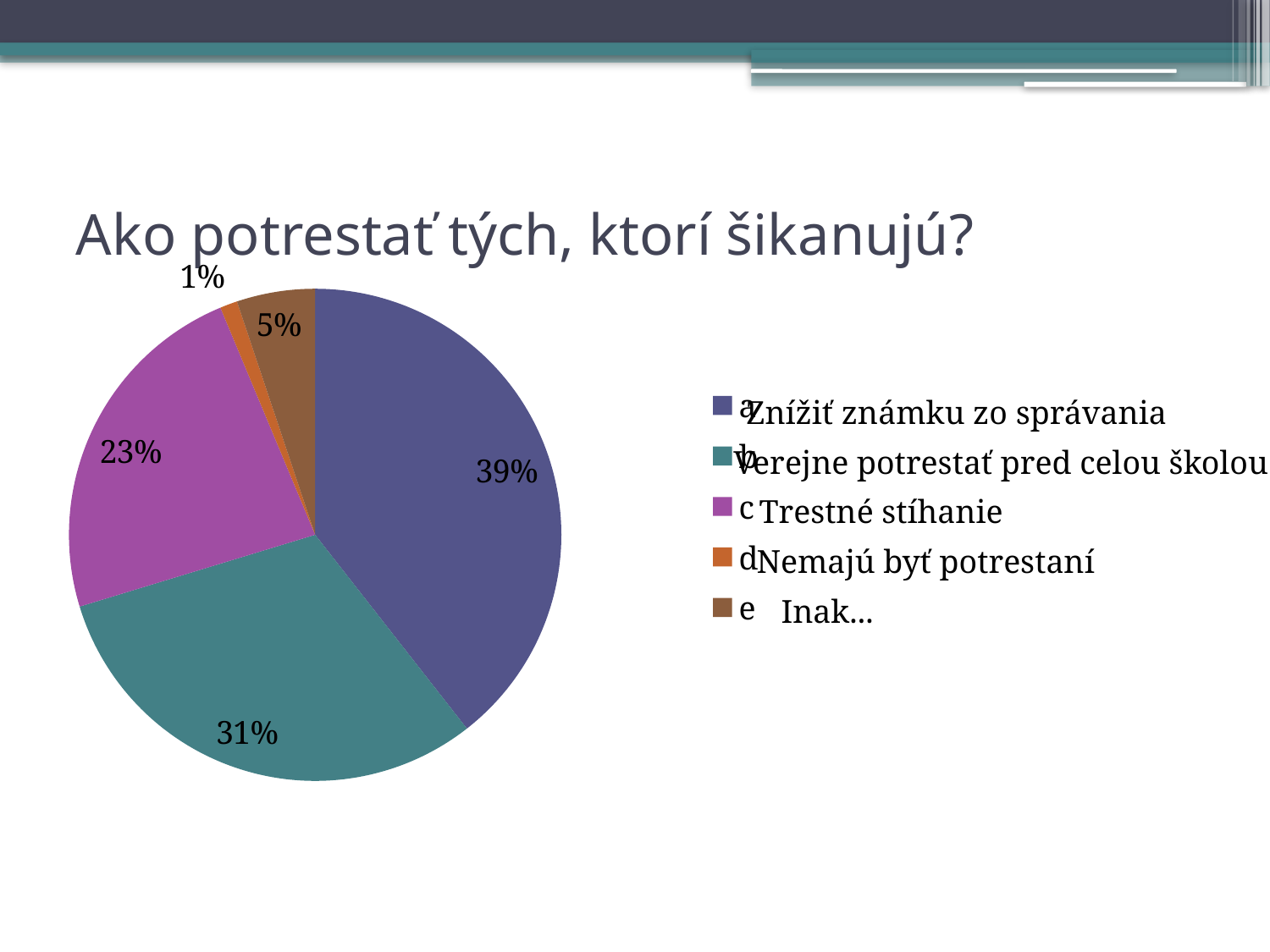
What share of the pie does "Znížiť známku zo správania" have? 39% What share of the pie does "Verejne potrestať pred celou školou" have? 31% What kind of chart is shown on the slide? pie chart What share of the pie does "Inak..." have? 5% What share of the pie does "Nemajú byť potrestaní" have? 1% What is the title of the slide containing the pie chart? Ako potrestať tých, ktorí šikanujú? What share of the pie does "Trestné stíhanie" have? 23% What is the difference between the shares for "Znížiť známku zo správania" and "Trestné stíhanie"? 16% Which category has the smallest slice of the pie? Nemajú byť potrestaní Which category has the largest slice of the pie? Znížiť známku zo správania Which is larger, the share for "Verejne potrestať pred celou školou" or the share for "Inak..."? Verejne potrestať pred celou školou How many slices does the pie chart have? 5